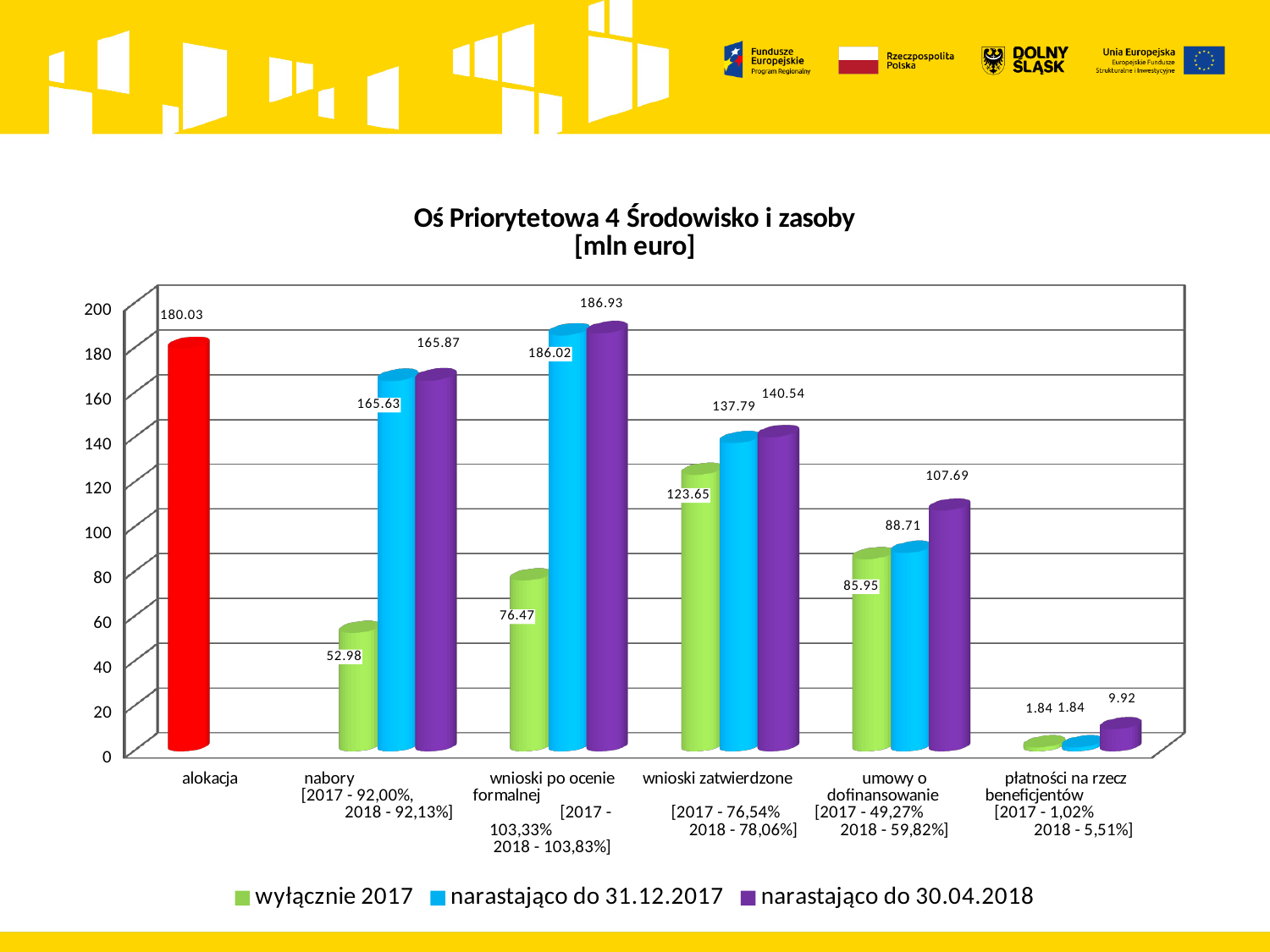
How many series does the legend list? 3 What type of chart is shown on the slide? bar chart What is the value for 'narastająco do 31.12.2017' in the 'wnioski po ocenie formalnej' category? 186.02 What is the value for 'narastająco do 30.04.2018' in the 'umowy o dofinansowanie' category? 107.69 Which category has the lowest value for the 'narastająco do 30.04.2018' series? płatności na rzecz beneficjentów What is the difference between the 'narastająco do 30.04.2018' and 'narastająco do 31.12.2017' values in the 'umowy o dofinansowanie' category? 18.98 Which is larger in the 'wnioski zatwierdzone' category: the 'wyłącznie 2017' value or the 'narastająco do 31.12.2017' value? narastająco do 31.12.2017 What unit is given in the chart title? mln euro What is the value of the 'alokacja' bar? 180.03 What is the value for 'wyłącznie 2017' in the 'nabory' category? 52.98 Which category has the highest value for the 'wyłącznie 2017' series? wnioski zatwierdzone How many categories are shown on the x axis? 6